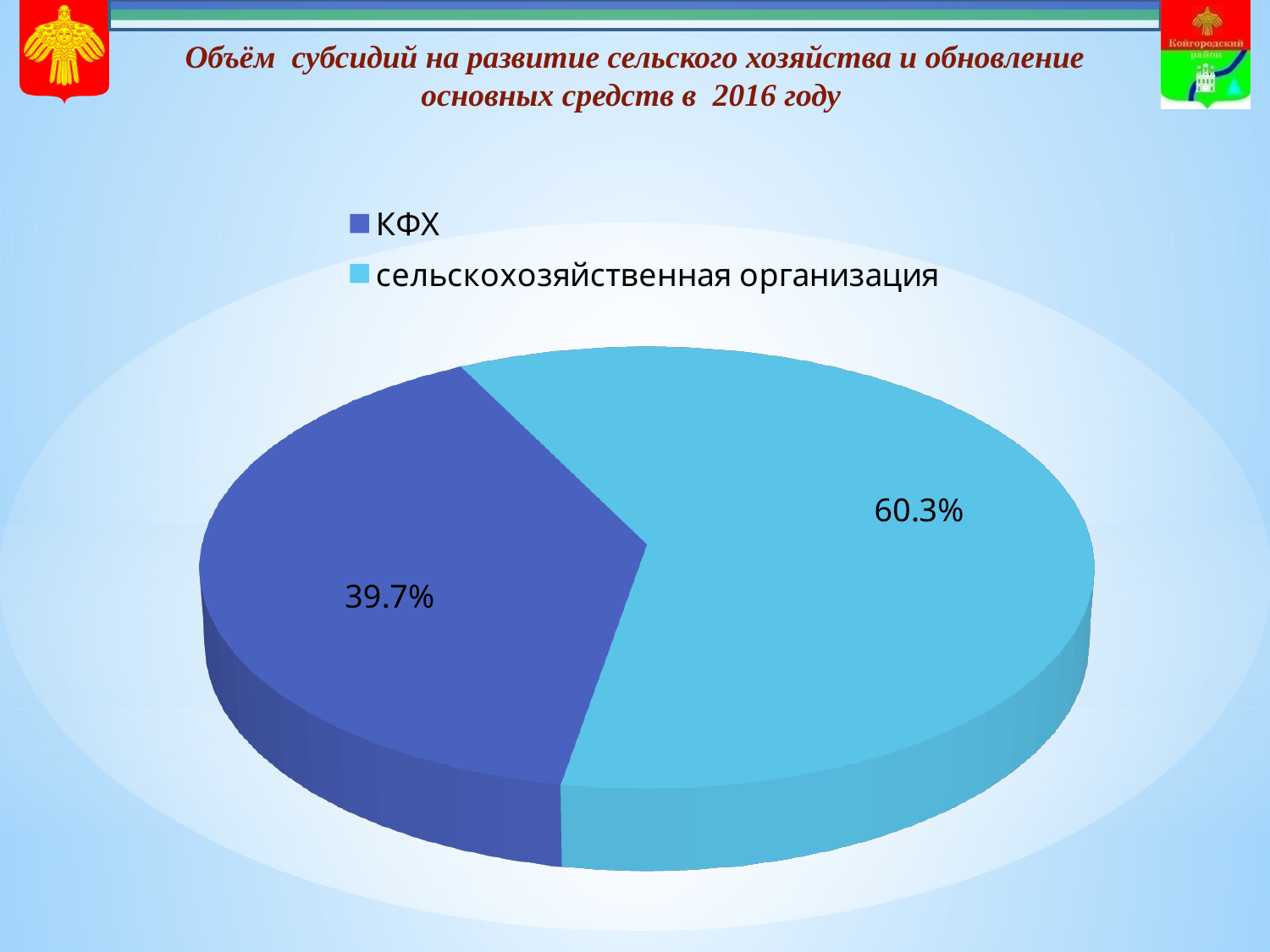
How many slices does the pie chart have? 2 Is the share for КФХ greater or less than 50%? less What is the difference in percentage points between the share for сельскохозяйственная организация and the share for КФХ? 20.6 Which category has the largest share of the pie? сельскохозяйственная организация What kind of chart is shown on the slide? pie chart How many entries does the legend list? 2 What year does the chart title refer to? 2016 Which category has the smallest share of the pie? КФХ What share of the pie does КФХ have? 39.7% What colour is the slice for КФХ? dark blue What share of the pie does сельскохозяйственная организация have? 60.3% Which is larger: the share for КФХ or the share for сельскохозяйственная организация? сельскохозяйственная организация